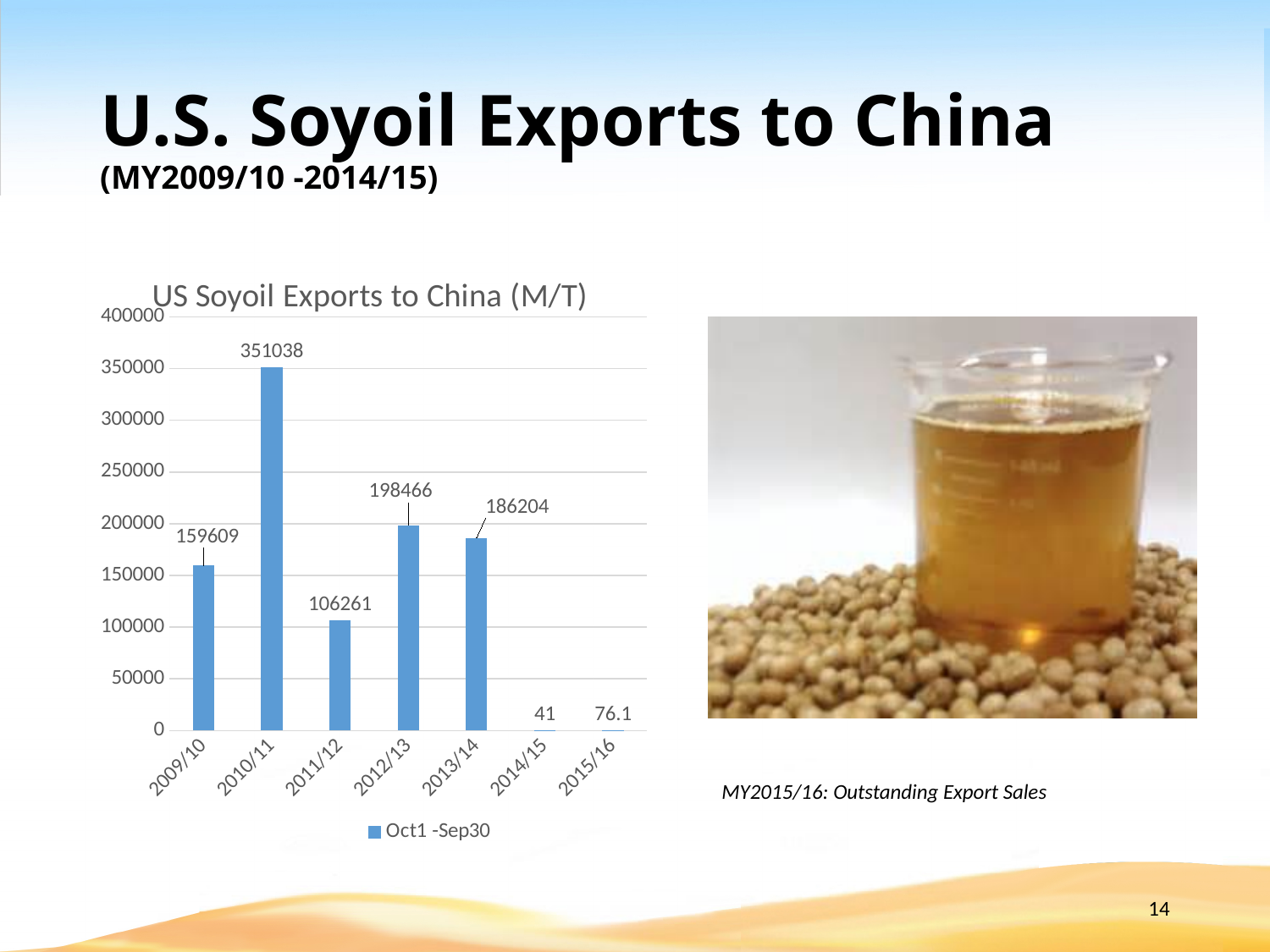
Which year has the highest value? 2010/11 Is the value for 2012/13 greater or less than 150000? greater What kind of chart is shown? bar chart What is the value for 2010/11? 351038 What is the value for 2014/15? 41 What is the title of the chart? US Soyoil Exports to China (M/T) What is the difference between the values for 2012/13 and 2013/14? 12262 What is the value for 2011/12? 106261 Which year has the lowest value? 2014/15 How many years are shown on the x axis? 7 Which is larger, the value for 2009/10 or the value for 2011/12? 2009/10 How many series does the legend list? 1